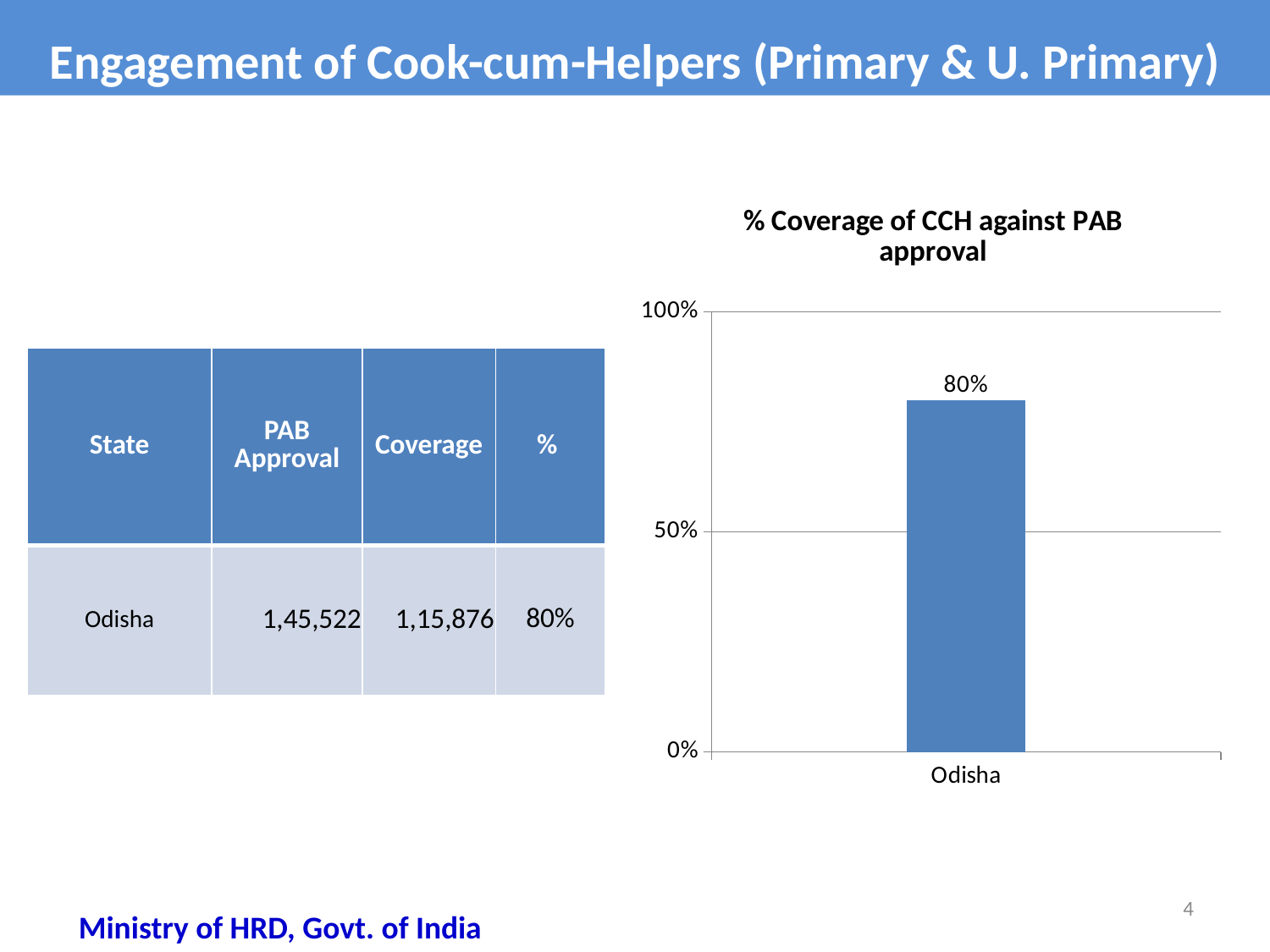
What kind of chart is shown on the slide? bar chart Is the value for Odisha greater or less than 50%? greater Which category is shown on the x axis of the chart? Odisha What is the highest value shown on the chart's y axis? 100% How many categories are plotted in the chart? 1 Is the value for Odisha greater or less than 100%? less What is the value for Odisha in the chart? 80% What is the title of the chart? % Coverage of CCH against PAB approval